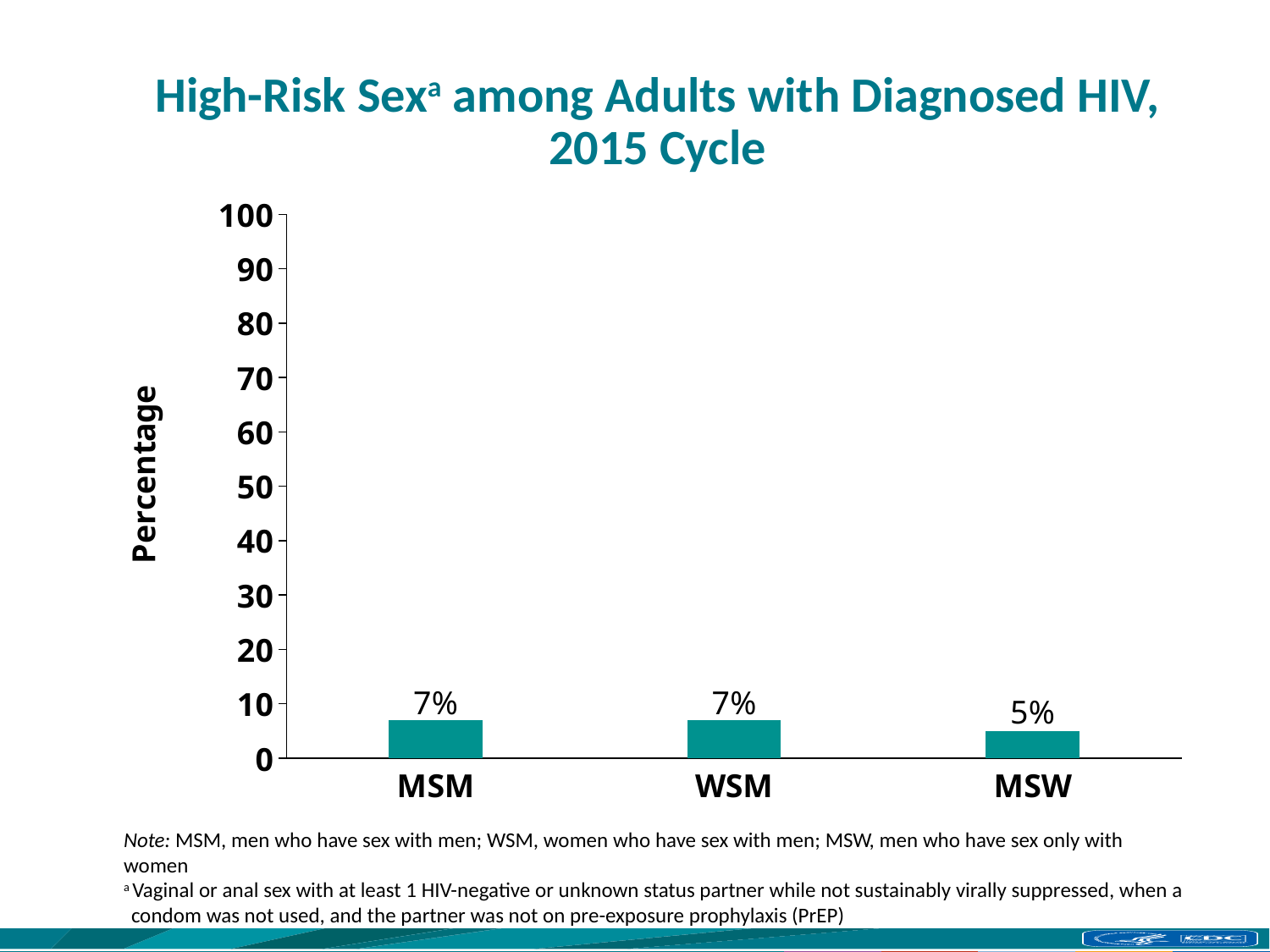
Which is larger, the value for WSM or the value for MSW? WSM How many categories are shown on the x axis? 3 What is the difference between the values for MSM and MSW? 2% What is the value for MSM? 7% What is the maximum value shown on the y axis? 100 What is the label of the y axis? Percentage Do the values for MSM and WSM differ? No, both are 7% What kind of chart is shown on the slide? bar chart Is the value for MSM greater or less than 10? less What is the value for WSM? 7% Which category has the lowest value? MSW What is the value for MSW? 5%